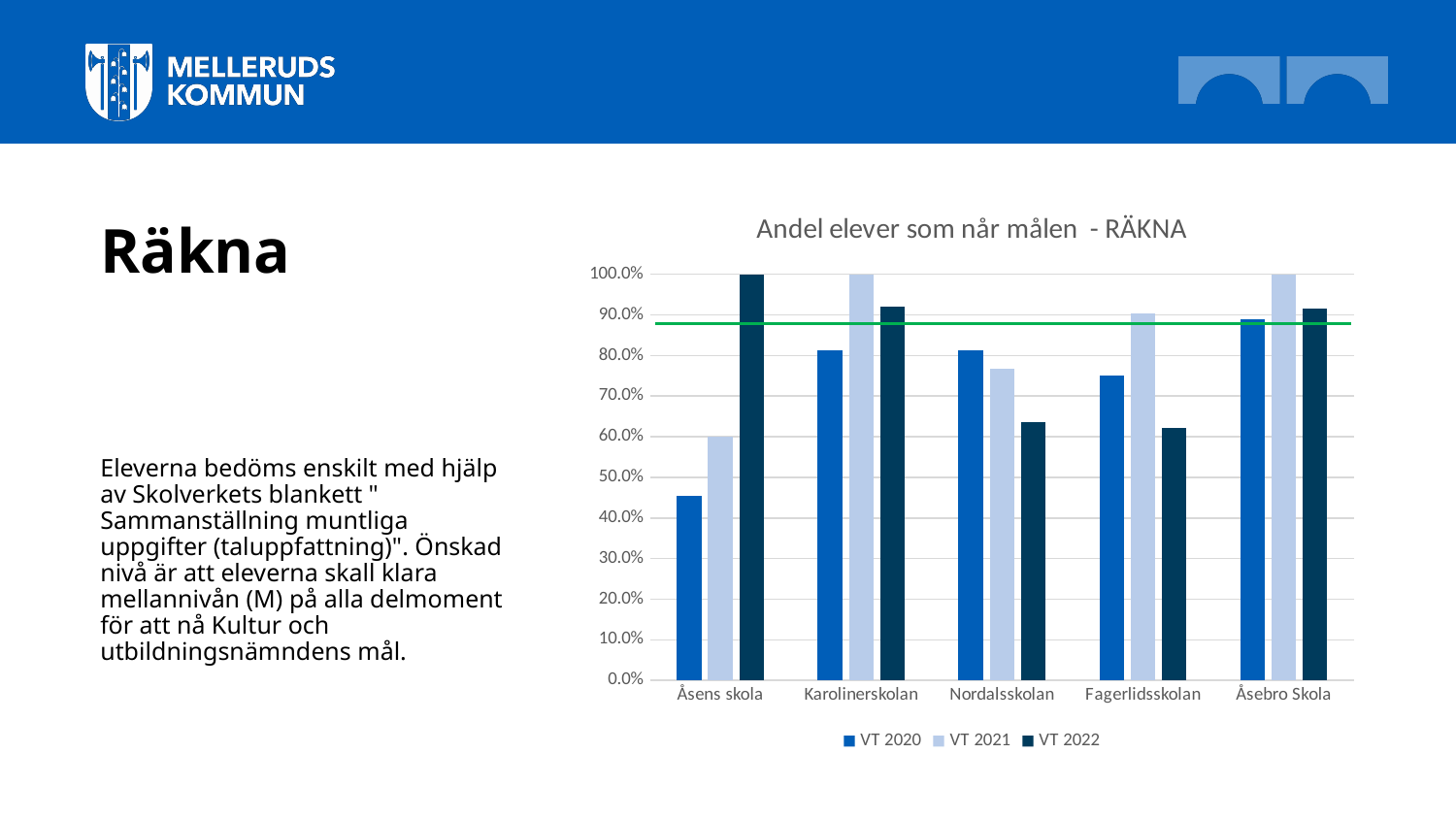
What is the VT 2021 value for Karolinerskolan? 100.0% What is the title of the chart? Andel elever som når målen - RÄKNA Do the values for Åsens skola rise or fall from VT 2020 to VT 2022? rise Is the VT 2020 value for Åsens skola greater or less than 50.0%? less For Nordalsskolan, which is larger: the VT 2020 value or the VT 2022 value? VT 2020 What is the VT 2021 value for Åsebro Skola? 100.0% Which school has the lowest VT 2020 value? Åsens skola How many schools are shown on the x axis of the chart? 5 What kind of chart is shown on the slide? bar chart How many series does the chart legend list? 3 Is the VT 2022 value for Fagerlidsskolan greater or less than 70.0%? less What is the VT 2022 value for Åsens skola? 100.0%